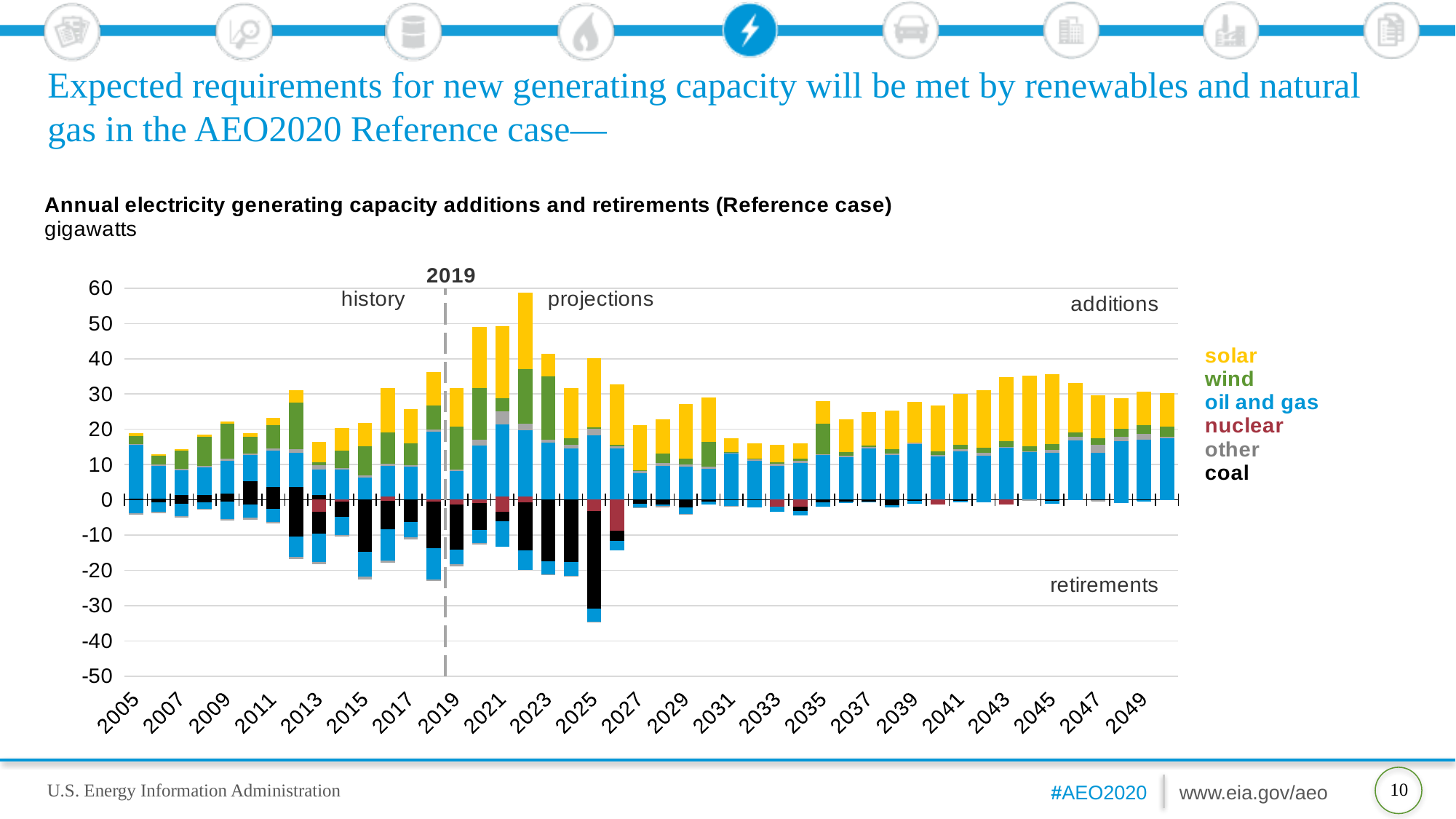
Which year has larger total additions, 2023 or 2020? 2020 Which year has the largest capacity retirements (most negative bar)? 2026 Which year has the highest total capacity additions? 2022 Are the total additions in 2044 greater or less than 30 gigawatts? greater What unit is the chart measured in? gigawatts Are the total additions in 2031 greater or less than 20 gigawatts? less Do total capacity additions generally rise or fall from 2036 to 2044? rise Which year does the dashed vertical line separating history from projections mark? 2019 Are the total additions in 2020 greater or less than 40 gigawatts? greater How many series does the legend list? 6 What kind of chart is shown on the slide? stacked bar chart